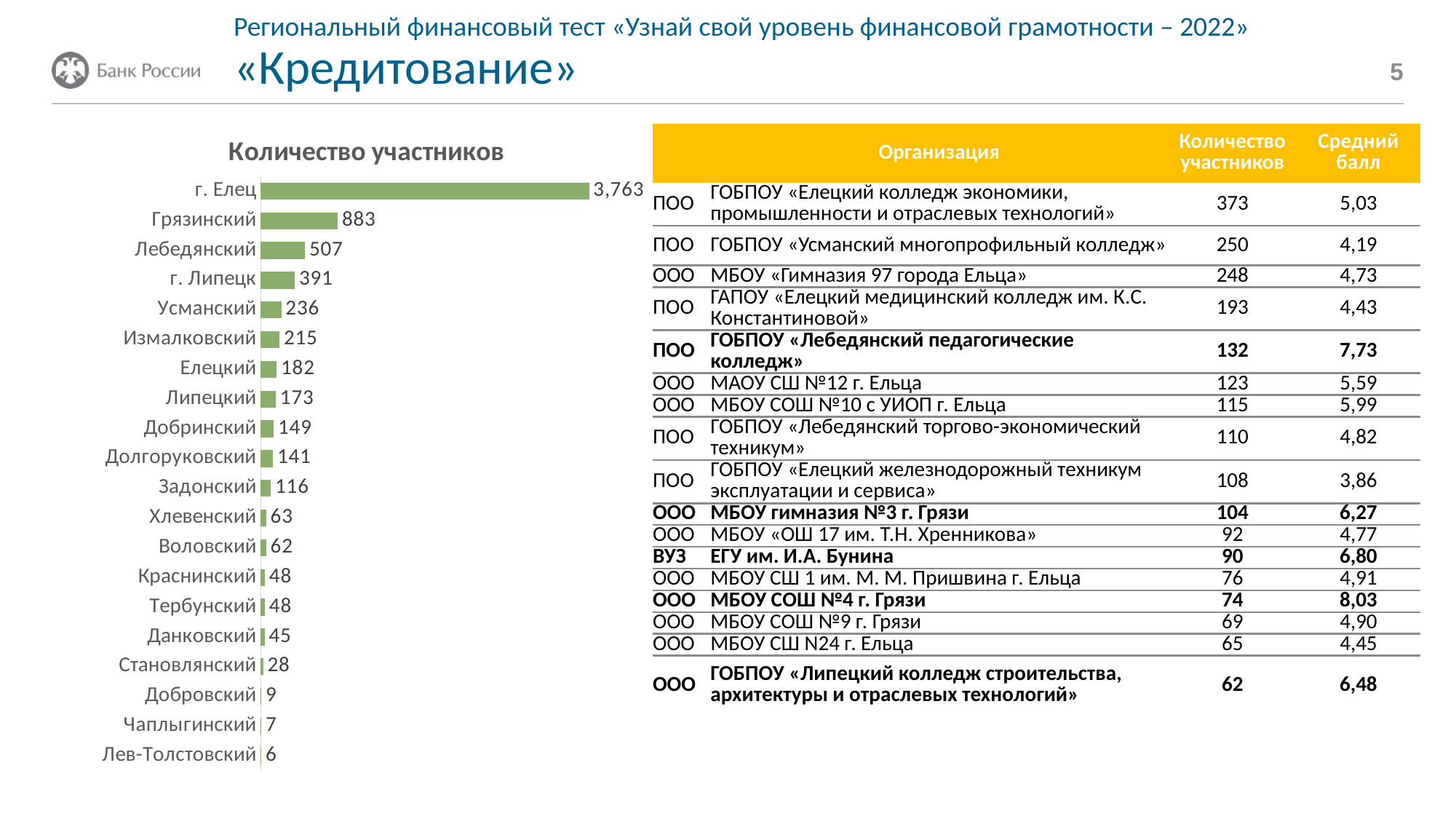
What is the difference between the values for Грязинский and Лебедянский? 376 What is the value for Грязинский? 883 Which category has the lowest value? Лев-Толстовский What is the difference between the values for Лебедянский and г. Липецк? 116 What is the value for г. Елец? 3,763 What is the value for Задонский? 116 What type of chart is shown on the slide? bar chart How many categories are shown in the chart? 20 Which category has the highest value? г. Елец What is the value for Становлянский? 28 What is the title of the chart? Количество участников Which is larger, the value for Усманский or the value for Измалковский? Усманский